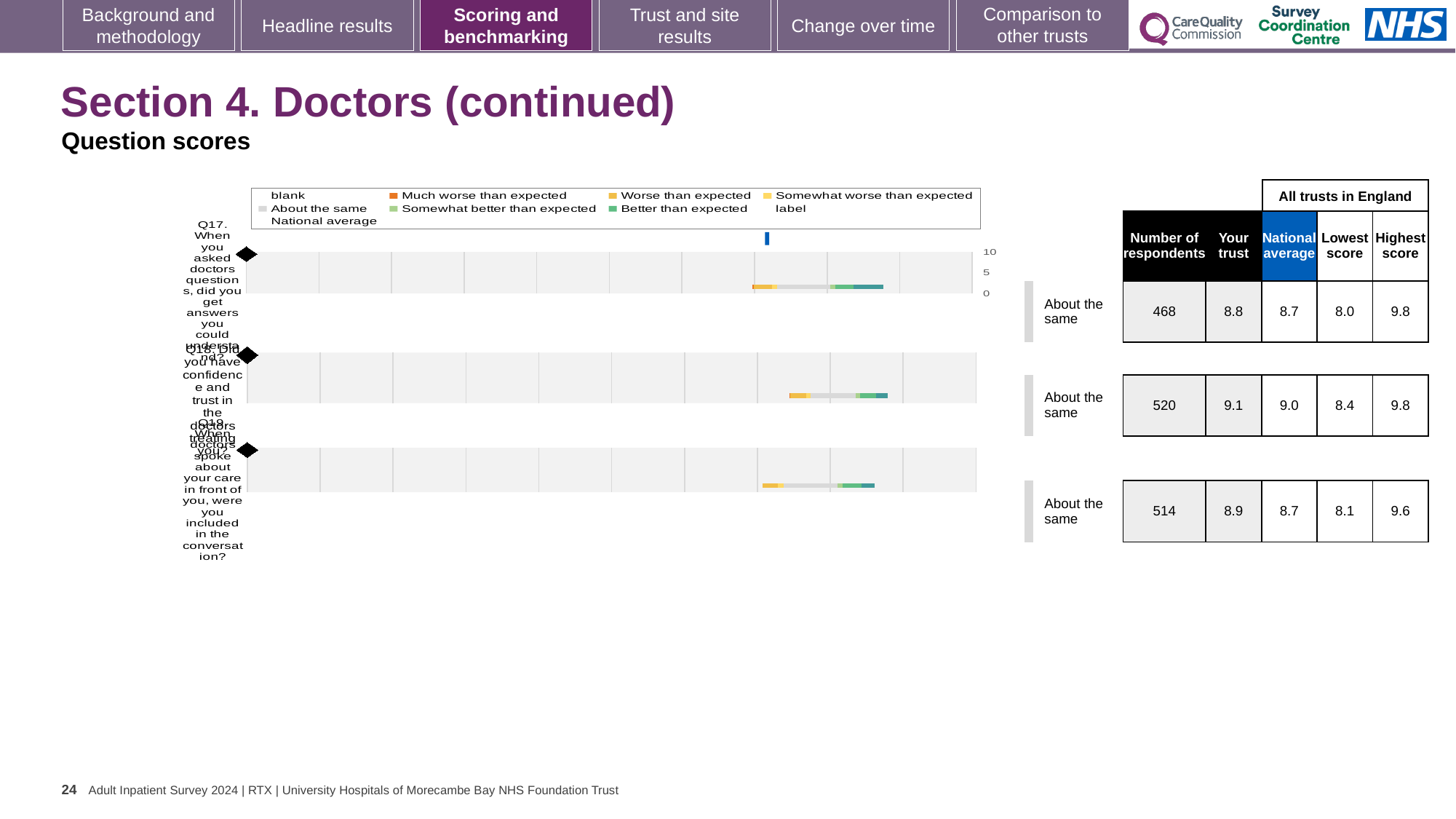
How many questions (Q17, Q18, Q19) are plotted on the slide? 3 How many respondents answered Q19 (When doctors spoke about your care in front of you, were you included in the conversation)? 514 What is the national average score for Q18 (Did you have confidence and trust in the doctors treating you)? 9.0 For Q18, what is the difference between the highest score and the lowest score across all trusts in England? 1.4 What is the maximum value shown on the chart's score axis? 10 For Q17, which is larger: the 'Your trust' score or the national average? Your trust What is the 'Your trust' score for Q17 (When you asked doctors questions, did you get answers you could understand)? 8.8 Which question has the highest 'Your trust' score? Q18 What benchmark category is shown for Q19? About the same What is the lowest score across all trusts in England for Q17? 8.0 What kind of chart is used to show the question scores for Q17, Q18 and Q19? bar chart